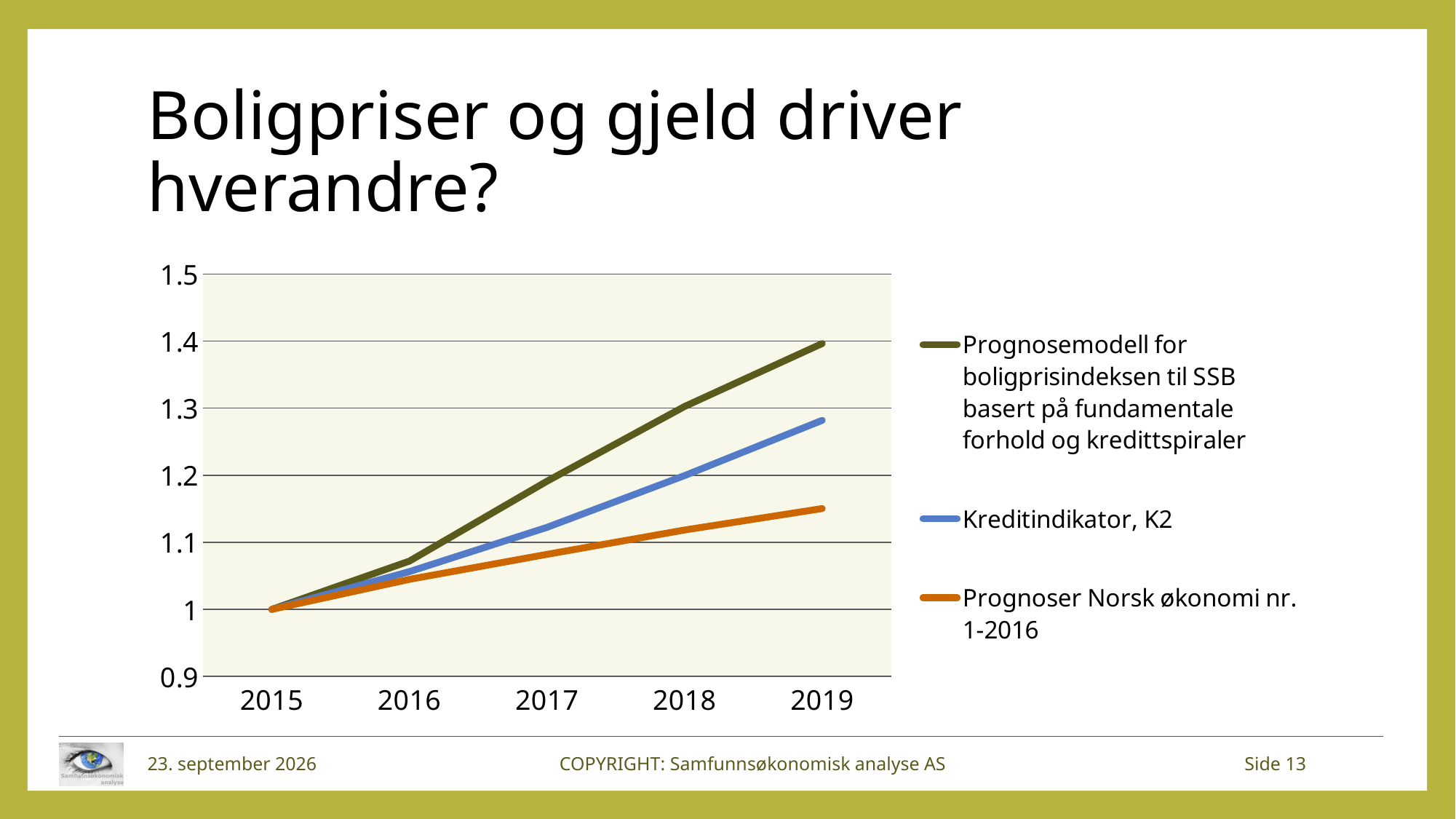
Is the value for Prognosemodell for boligprisindeksen til SSB in 2018 greater or less than 1.2? greater How many series does the legend list? 3 Is the value for Prognoser Norsk økonomi nr. 1-2016 in 2019 greater or less than 1.2? less What is the value of all three series in 2015? 1 How many years are shown along the x axis? 5 Which series has the lowest value in 2019? Prognoser Norsk økonomi nr. 1-2016 In 2018, which is larger: Kreditindikator, K2 or Prognoser Norsk økonomi nr. 1-2016? Kreditindikator, K2 What kind of chart is shown on the slide? line chart What colour is the line for Kreditindikator, K2? blue Is the value for Kreditindikator, K2 in 2019 greater or less than 1.2? greater Do the values of the Kreditindikator, K2 series rise or fall from 2015 to 2019? rise Which series has the highest value in 2019? Prognosemodell for boligprisindeksen til SSB basert på fundamentale forhold og kredittspiraler